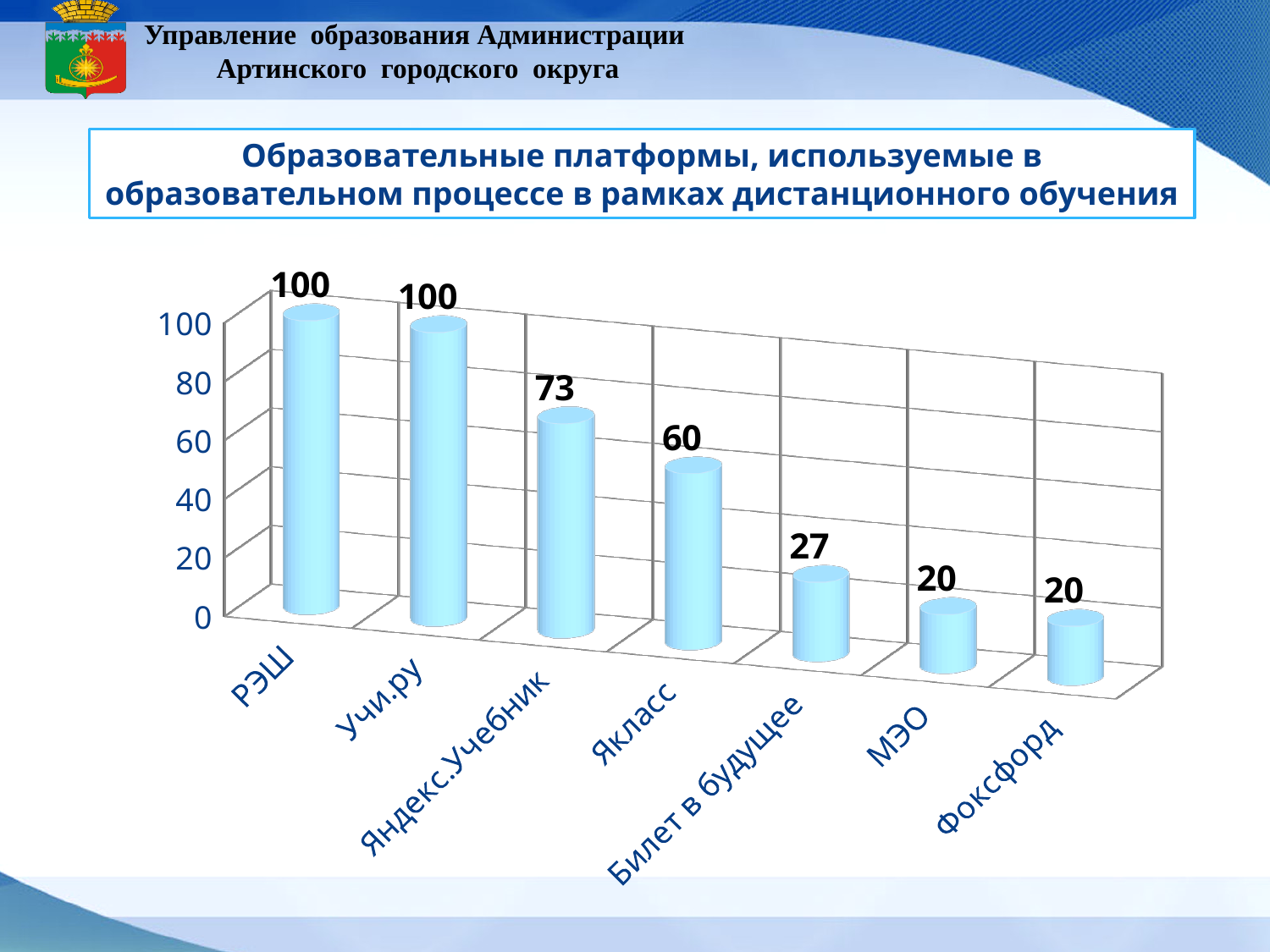
What is the difference between the values for Яндекс.Учебник and Якласс? 13 Which categories have the highest value? РЭШ and Учи.ру How many categories are shown in the chart? 7 What is the value for Учи.ру? 100 Which categories have the lowest value? МЭО and Фоксфорд What kind of chart is shown on the slide? bar chart Which is larger, the value for Якласс or the value for Билет в будущее? Якласс Do the values rise or fall from left to right along the x axis? fall What is the value for Билет в будущее? 27 What is the value for Яндекс.Учебник? 73 What is the value for Якласс? 60 What is the difference between the values for РЭШ and Билет в будущее? 73